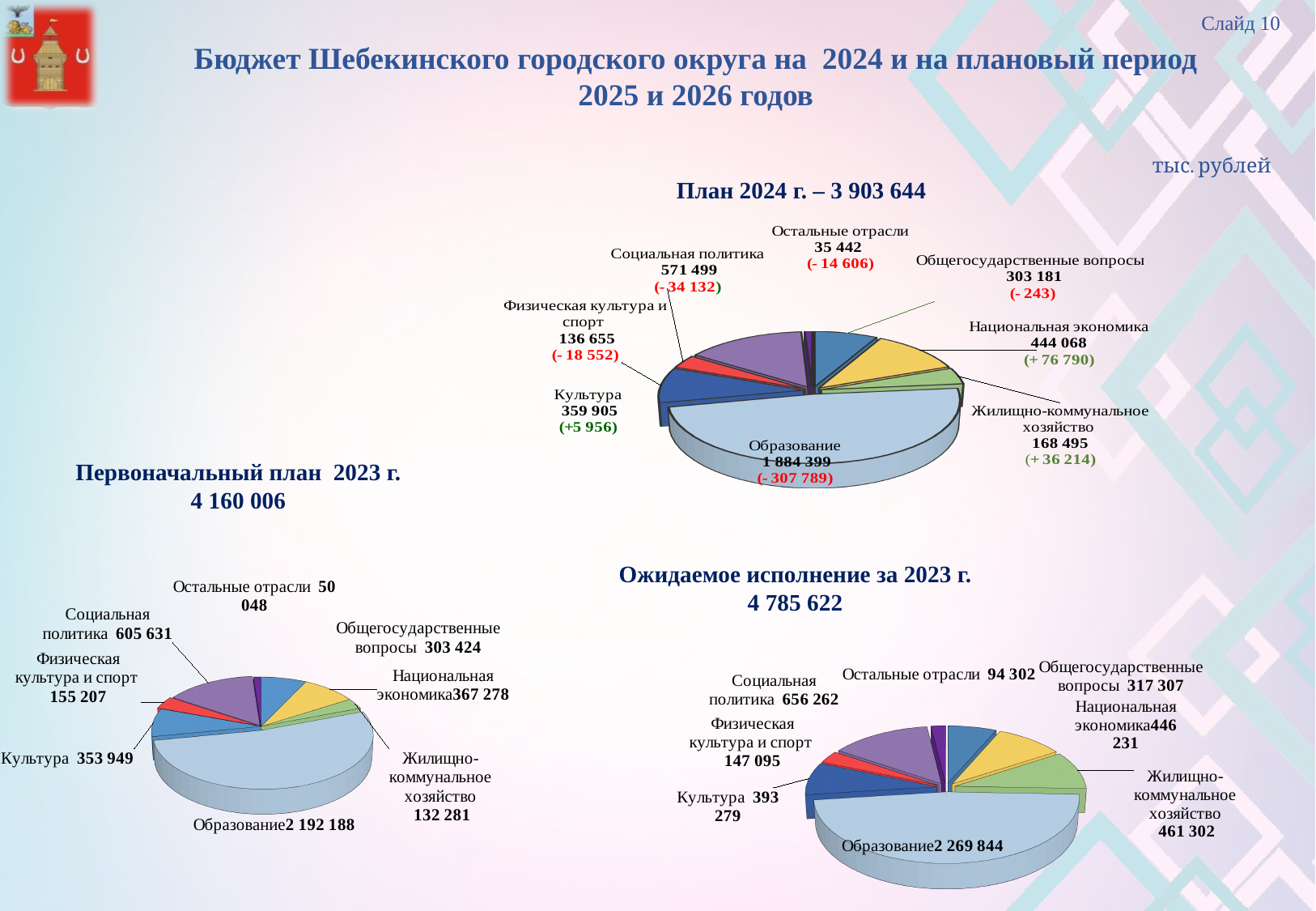
On the 'Первоначальный план 2023 г.' pie chart, which is larger: Национальная экономика or Культура? Национальная экономика On the 'План 2024 г.' pie chart, what is the value for Национальная экономика? 444 068 On the 'План 2024 г.' pie chart, what is the difference between Социальная политика and Культура? 211 594 On the 'Первоначальный план 2023 г.' pie chart, which category has the largest value? Образование On the 'План 2024 г.' pie chart, what is the value for Образование? 1 884 399 On the 'План 2024 г.' pie chart, which category has the smallest value? Остальные отрасли On the 'Ожидаемое исполнение за 2023 г.' pie chart, what is the difference between Жилищно-коммунальное хозяйство and Национальная экономика? 15 071 On the 'Первоначальный план 2023 г.' pie chart, what is the value for Жилищно-коммунальное хозяйство? 132 281 How many categories are shown on the 'План 2024 г.' pie chart? 8 What total is shown in the title of the 'Ожидаемое исполнение за 2023 г.' pie chart? 4 785 622 On the 'Ожидаемое исполнение за 2023 г.' pie chart, what is the value for Социальная политика? 656 262 What type of chart is used for 'Первоначальный план 2023 г.'? Pie chart